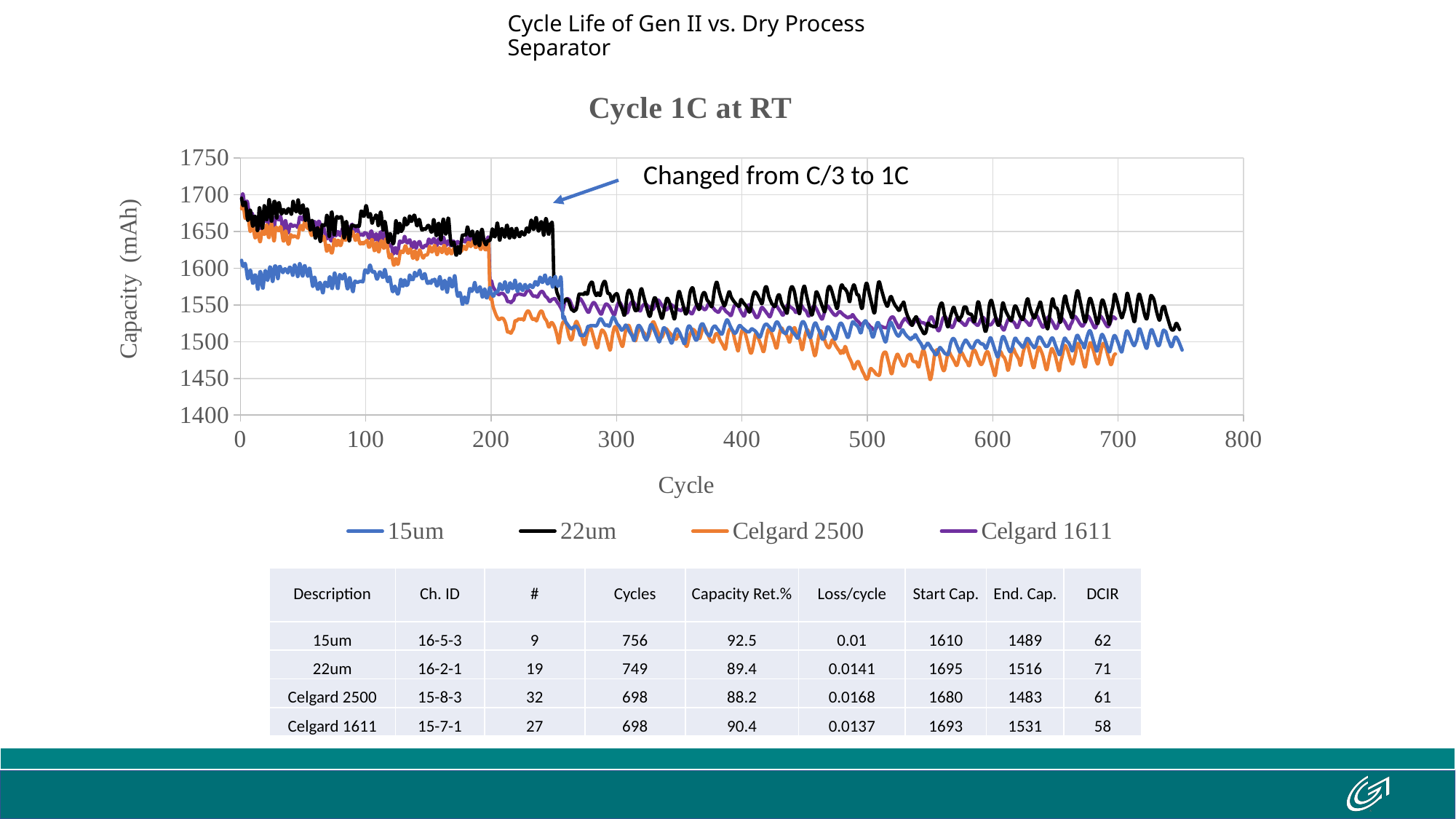
Is the capacity of the 22um series at cycle 0 greater or less than 1650? greater Does the capacity of the 15um series rise or fall overall as the cycle number increases? fall How many series does the legend of the chart list? 4 What is the title of the chart? Cycle 1C at RT At cycle 100, which series has the higher capacity, 22um or 15um? 22um What kind of chart is shown on the slide? line chart Is the capacity of the 15um series at cycle 100 greater or less than 1650? less Is the capacity of the Celgard 2500 series at cycle 500 greater or less than 1500? less Which series has the lowest capacity at cycle 500? Celgard 2500 At cycle 600, which series has the higher capacity, 22um or Celgard 2500? 22um What is the label of the y axis of the chart? Capacity (mAh) Which series has the lowest capacity during the first 200 cycles? 15um